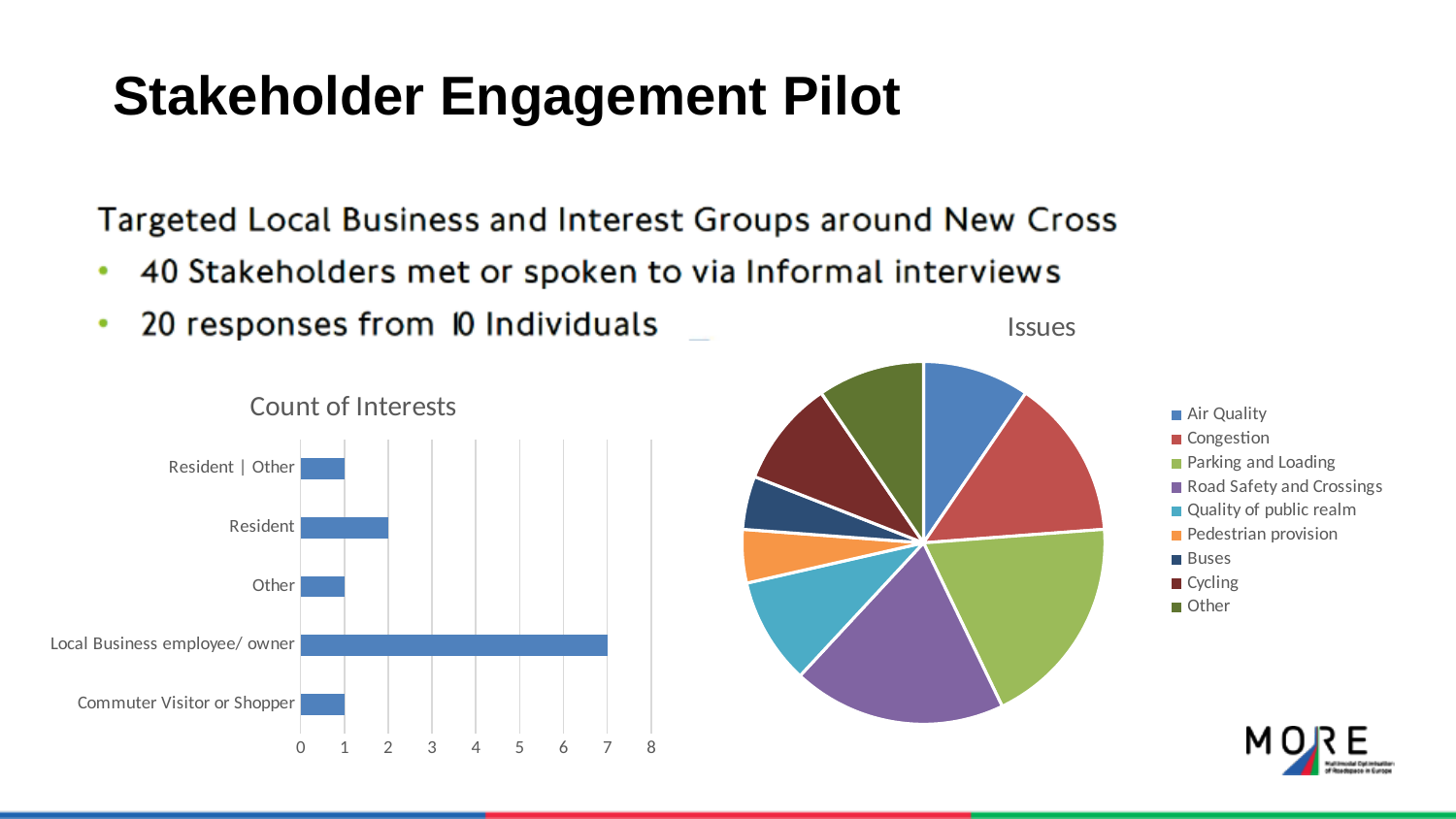
What kind of chart is the Issues chart? pie chart On the Count of Interests chart, which is larger, Resident or Other? Resident How many categories are shown on the Count of Interests chart? 5 On the Count of Interests chart, what is the value for Commuter Visitor or Shopper? 1 On the Count of Interests chart, what is the value for Resident? 2 On the Count of Interests chart, what is the difference between Local Business employee/ owner and Resident? 5 On the Count of Interests chart, which category has the highest value? Local Business employee/ owner How many entries does the legend of the Issues chart list? 9 On the Count of Interests chart, what is the value for Local Business employee/ owner? 7 On the Count of Interests chart, is the value for Local Business employee/ owner greater or less than 5? greater On the Issues chart, which slice is larger, Parking and Loading or Buses? Parking and Loading What kind of chart is the Count of Interests chart? bar chart